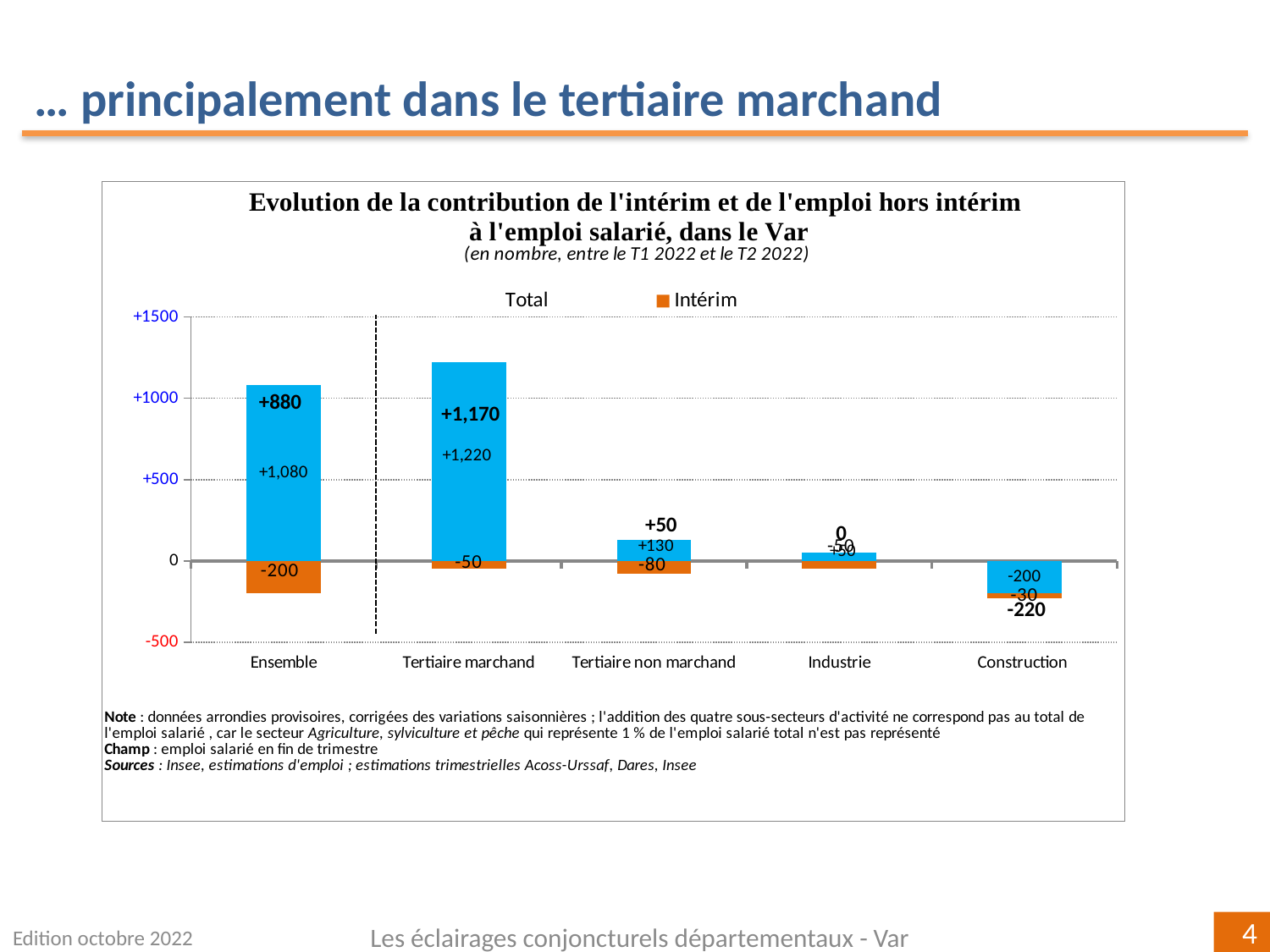
What is the total (bold label) for Tertiaire non marchand? +50 How many sector categories are shown along the x axis? 5 What is the total (bold label) for Tertiaire marchand? +1,170 What is the Intérim (orange) value for Construction? -30 What is the total (bold label) for Ensemble? +880 Which sector has the lowest total? Construction What is the value of the blue (hors intérim) segment for Tertiaire marchand? +1,220 What kind of chart is shown on the slide? bar chart What is the difference between the total for Tertiaire marchand (+1,170) and the total for Ensemble (+880)? 290 Which sector has the highest total? Tertiaire marchand Which has the larger total, Ensemble or Tertiaire marchand? Tertiaire marchand What is the Intérim (orange) value for Ensemble? -200